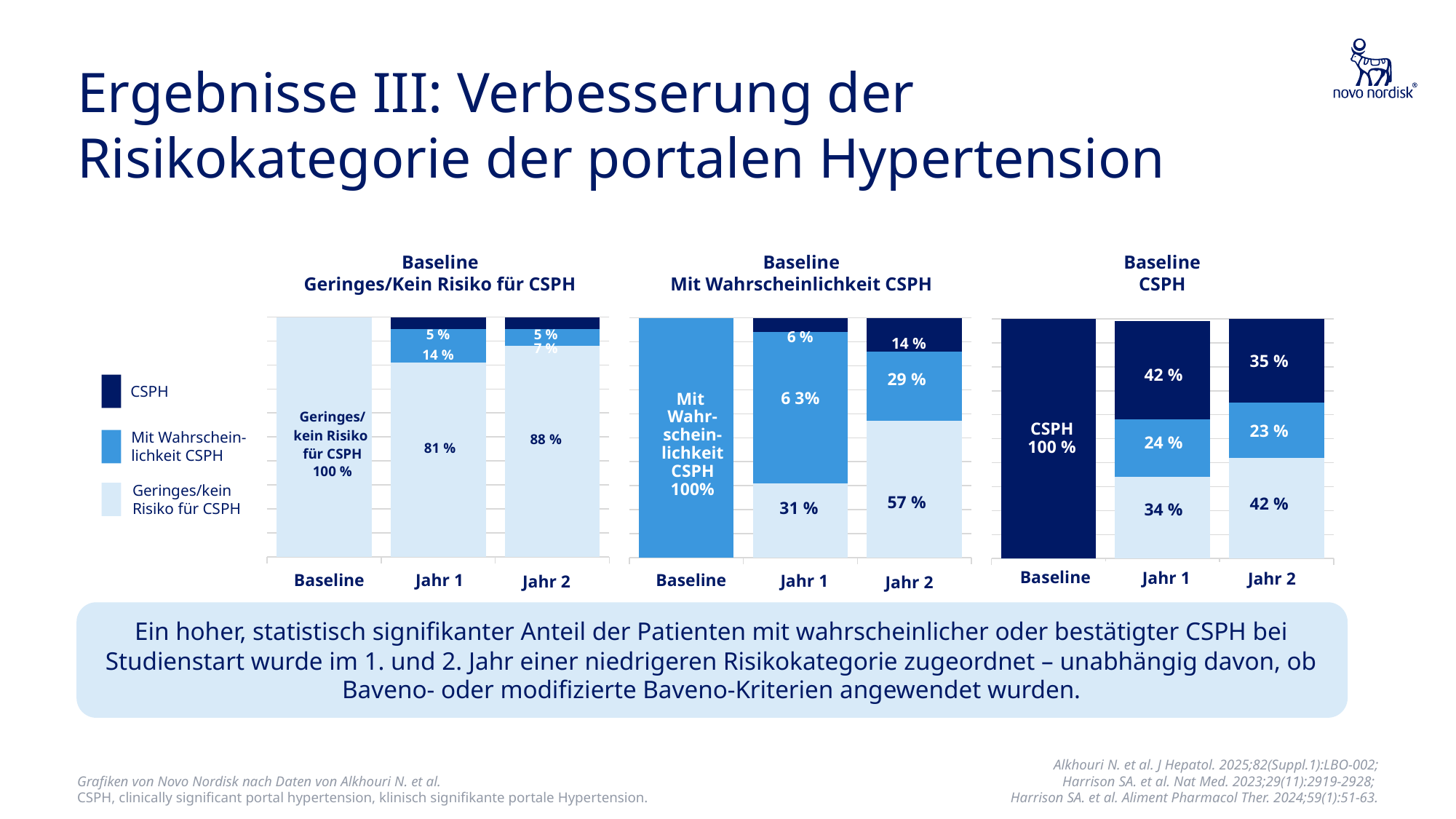
In the chart titled "Baseline CSPH", what share of patients are in the CSPH category in Jahr 1? 42 % In the chart titled "Baseline Mit Wahrscheinlichkeit CSPH", what share of patients are in the CSPH category in Jahr 2? 14 % In the chart titled "Baseline CSPH", what share of patients are in the Geringes/kein Risiko für CSPH category in Jahr 2? 42 % In the chart titled "Baseline Mit Wahrscheinlichkeit CSPH", what share of patients are in the Geringes/kein Risiko für CSPH category in Jahr 2? 57 % In the chart titled "Baseline Geringes/Kein Risiko für CSPH", what share of patients are in the Geringes/kein Risiko für CSPH category in Jahr 1? 81 % In the chart titled "Baseline CSPH", what is the difference between the CSPH share in Jahr 1 and in Jahr 2? 7 % How many bars does the chart titled "Baseline CSPH" have? 3 In the chart titled "Baseline Geringes/Kein Risiko für CSPH", which year has the larger Geringes/kein Risiko für CSPH share, Jahr 1 or Jahr 2? Jahr 2 In the chart titled "Baseline Mit Wahrscheinlichkeit CSPH", which year has the larger Geringes/kein Risiko für CSPH share, Jahr 1 or Jahr 2? Jahr 2 What kind of chart is the chart titled "Baseline CSPH"? Stacked bar chart How many series does the legend list? 3 In the chart titled "Baseline CSPH", what is the total of the Jahr 2 stacked bar? 100 %